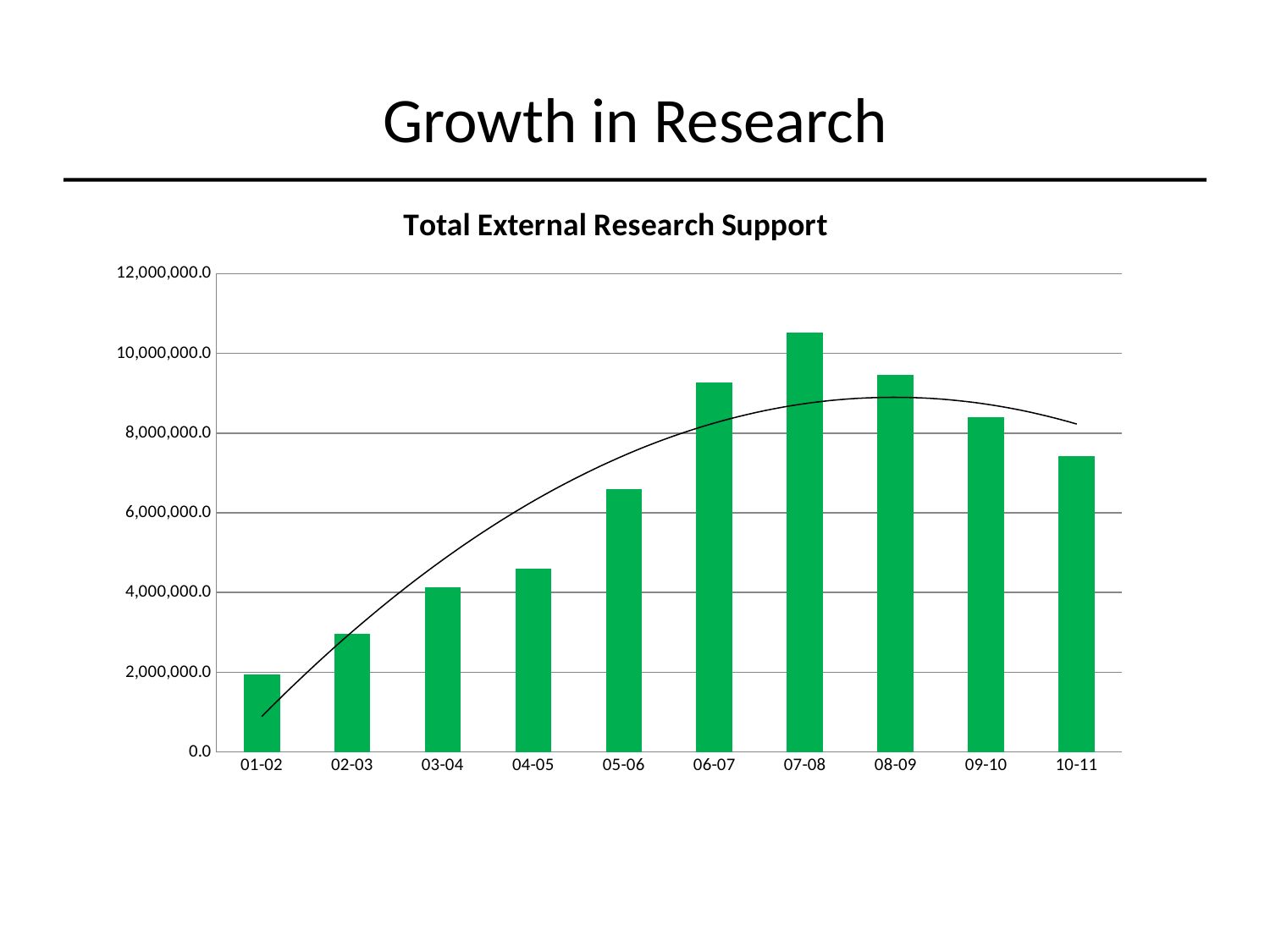
Is the value for 10-11 greater or less than 8,000,000.0? less How many categories (years) are plotted on the x axis? 10 Which is larger, the value for 06-07 or the value for 09-10? 06-07 Do the values rise or fall from 07-08 to 10-11? fall Is the value for 05-06 greater or less than 6,000,000.0? greater What kind of chart is shown on the slide? bar chart What is the title of the chart? Total External Research Support Do the values rise or fall from 01-02 to 07-08? rise Is the value for 07-08 greater or less than 10,000,000.0? greater Which year has the lowest Total External Research Support? 01-02 Which year has the highest Total External Research Support? 07-08